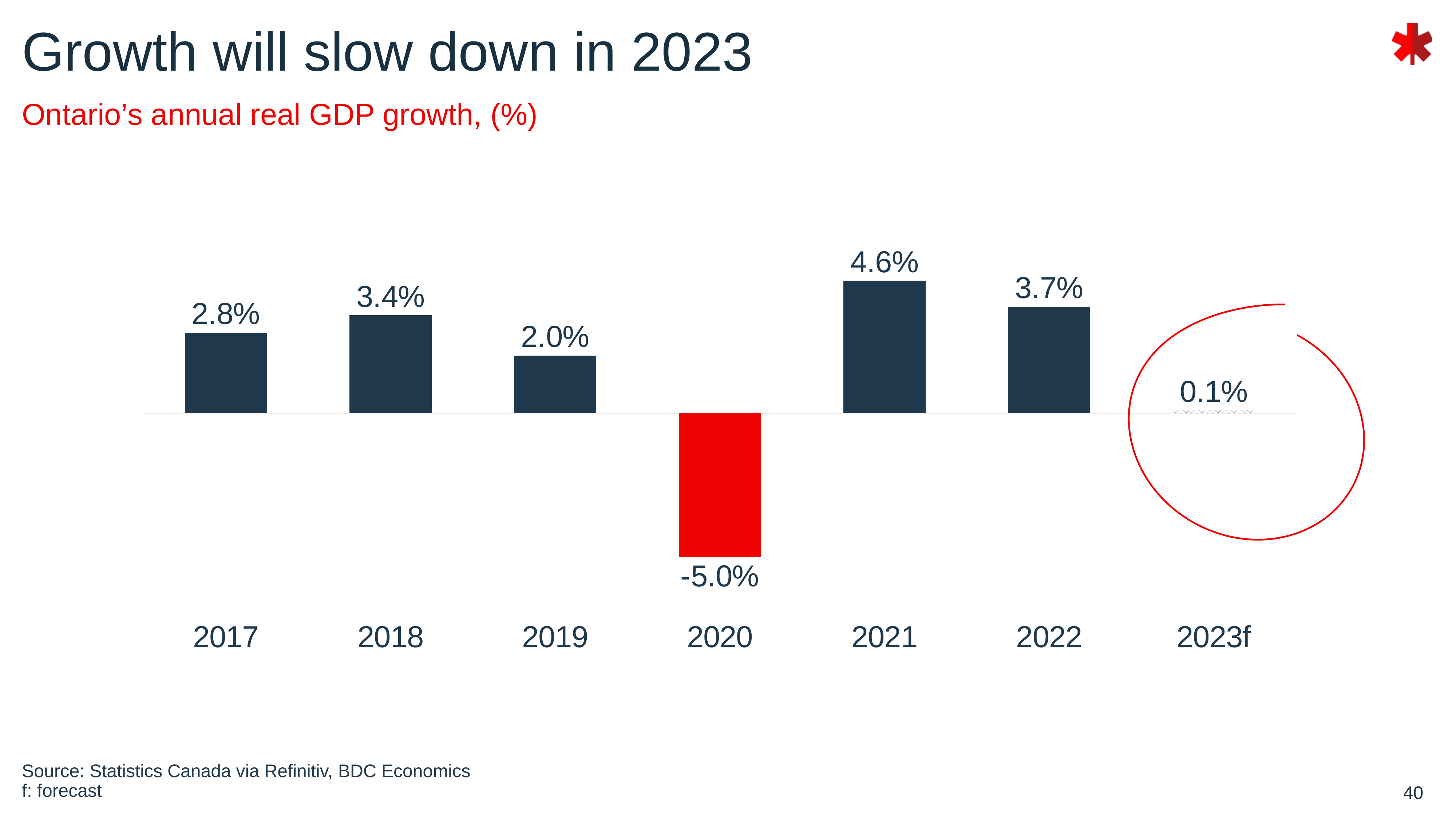
What is the subtitle of the chart? Ontario's annual real GDP growth, (%) How many years are shown on the x axis? 7 Which year has the lowest real GDP growth? 2020 Which year had higher real GDP growth, 2018 or 2019? 2018 Which year's bar is coloured red? 2020 Which year has the highest real GDP growth? 2021 What is the difference between the 2021 and 2022 growth values? 0.9% What is Ontario's annual real GDP growth for 2021? 4.6% Does real GDP growth rise or fall from 2021 to 2023f? Fall What kind of chart is shown on the slide? Bar chart What is the forecast real GDP growth for 2023f? 0.1% What is the real GDP growth value shown for 2020? -5.0%